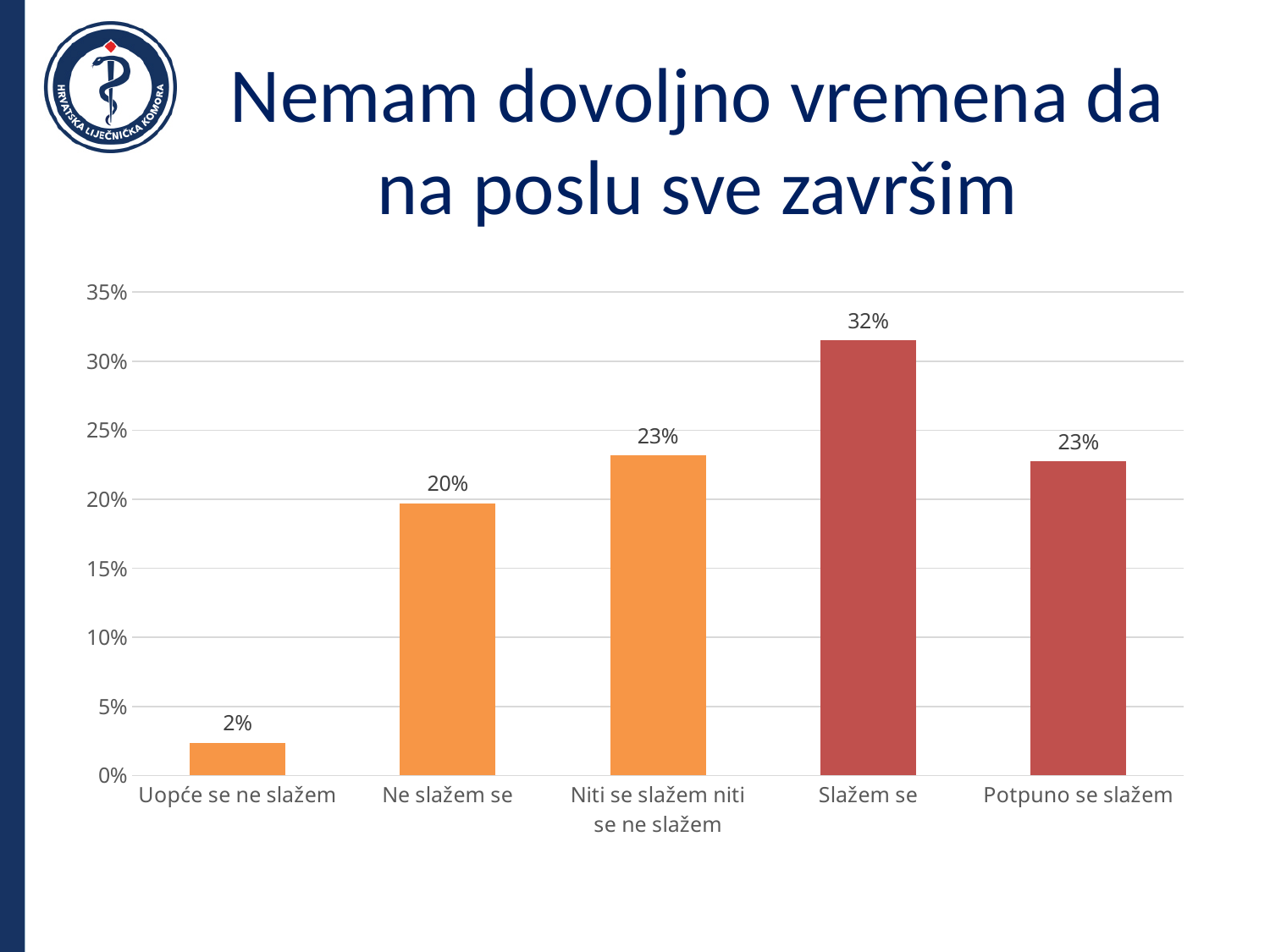
What is the value for "Slažem se"? 32% What is the value for "Ne slažem se"? 20% What is the highest value shown on the y axis? 35% Which category has the highest value? Slažem se What is the title of the slide? Nemam dovoljno vremena da na poslu sve završim What kind of chart is shown on the slide? Bar chart How many categories are shown on the x axis? 5 What is the difference between the values for "Slažem se" and "Potpuno se slažem"? 9% Which category has the lowest value? Uopće se ne slažem What is the value for "Uopće se ne slažem"? 2% Is the value for "Slažem se" greater or less than 30%? greater Which is larger, the value for "Ne slažem se" or the value for "Niti se slažem niti se ne slažem"? Niti se slažem niti se ne slažem